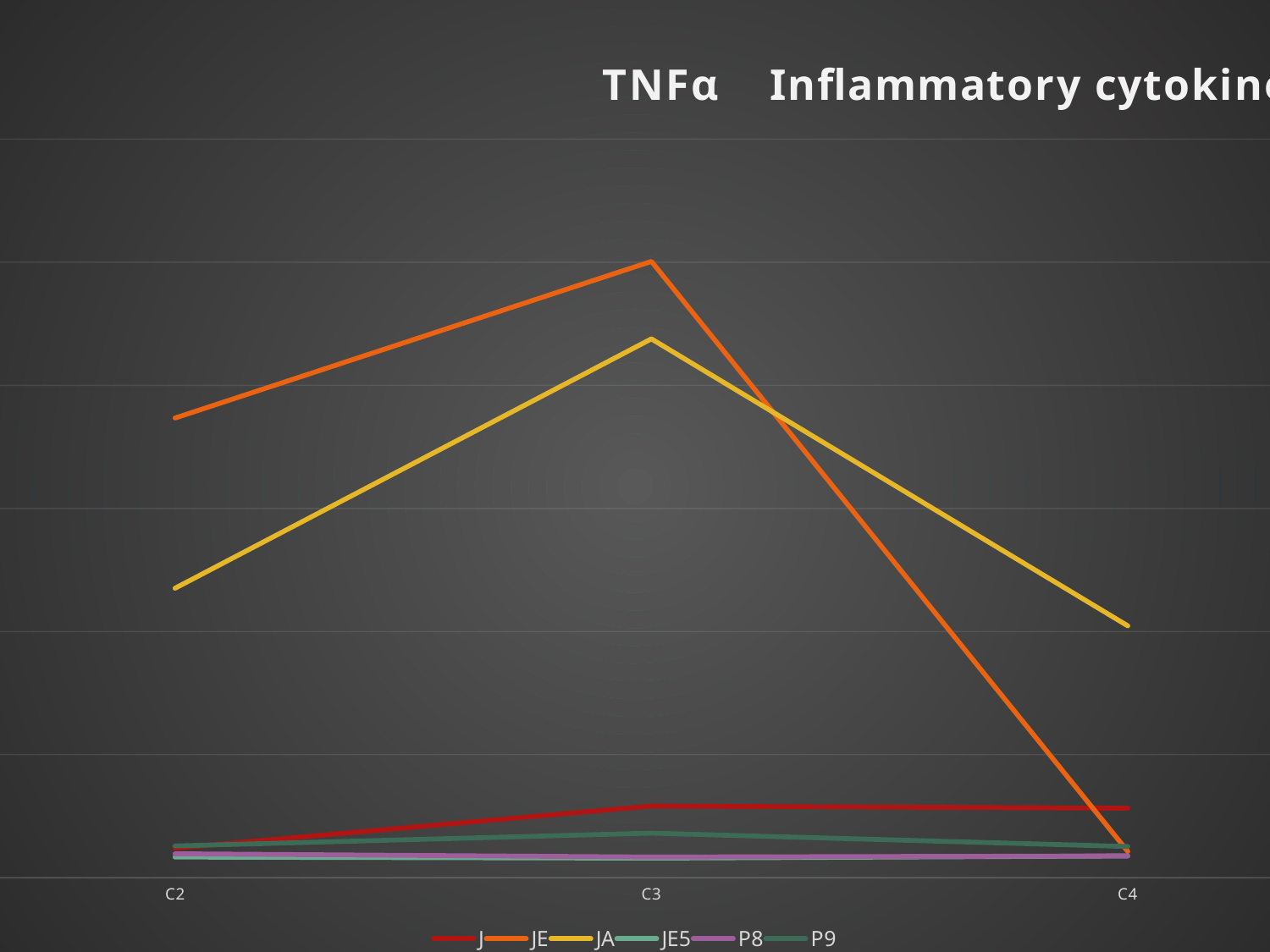
What is the first category on the x axis? C2 What colour is the JE series line? orange Does the JA series rise or fall from C2 to C3? rise Does the JE series rise or fall from C3 to C4? fall At C4, which is larger, the value for J or the value for P9? J Which series has the highest value at C3? JE At C2, which is larger, the value for JE or the value for JA? JE How many series does the legend list? 6 Which series has the highest value at C4? JA Which series has the highest value at C2? JE What kind of chart is shown on the slide? line chart How many categories are shown on the x axis? 3